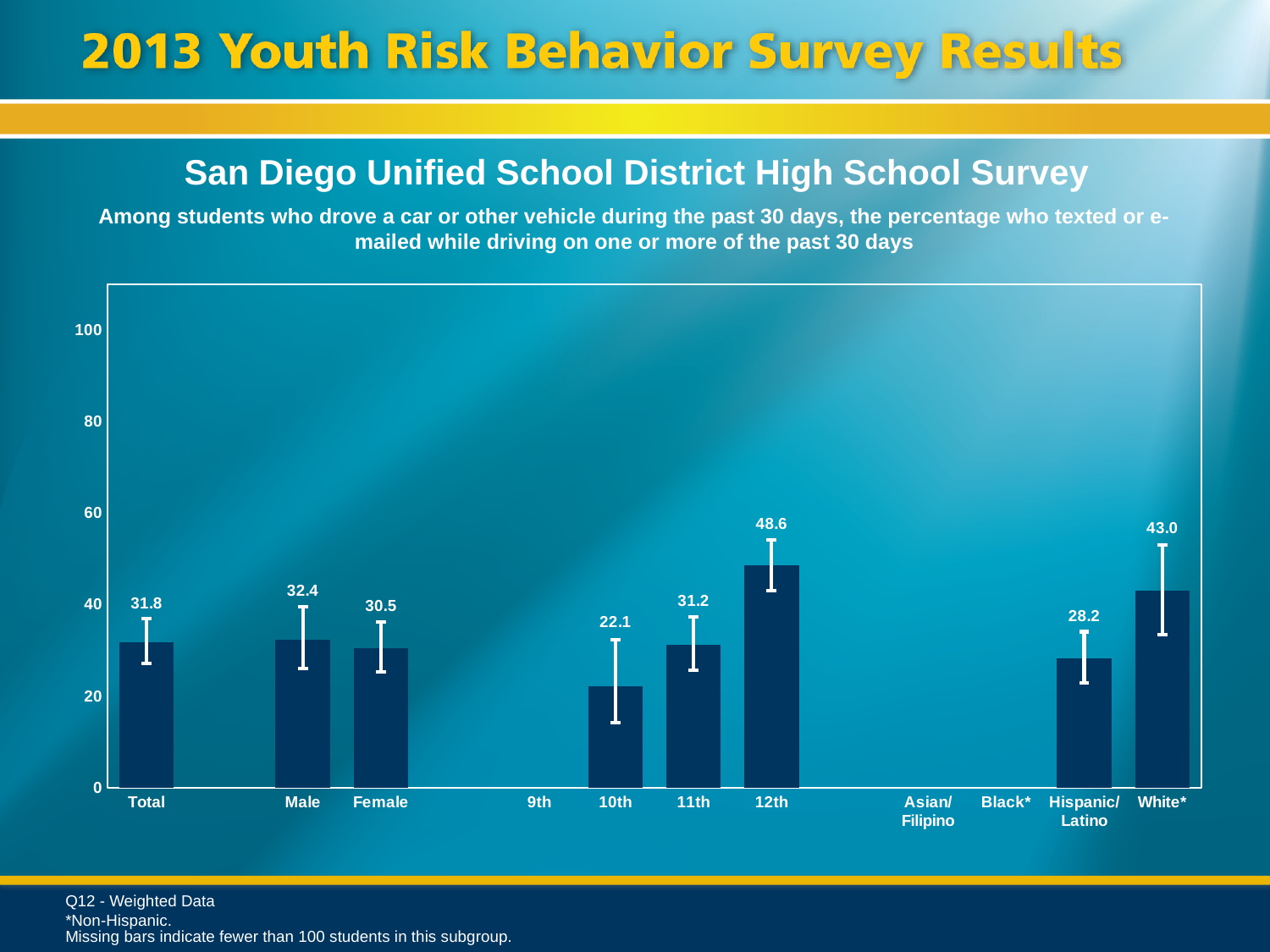
What kind of chart is shown on the slide? bar chart How many bars are plotted on the chart? 8 Is the value for 11th graders greater or less than 40? less Which is larger, the value for White* or the value for Hispanic/Latino? White* What is the value for Female students? 30.5 What is the difference between the values for Male and Female students? 1.9 Which category has the highest value? 12th Which category has the lowest plotted value? 10th Do the values rise or fall from 10th grade to 12th grade? rise What is the difference between the values for 12th and 10th graders? 26.5 What is the value for Hispanic/Latino students? 28.2 What is the value for 12th graders? 48.6